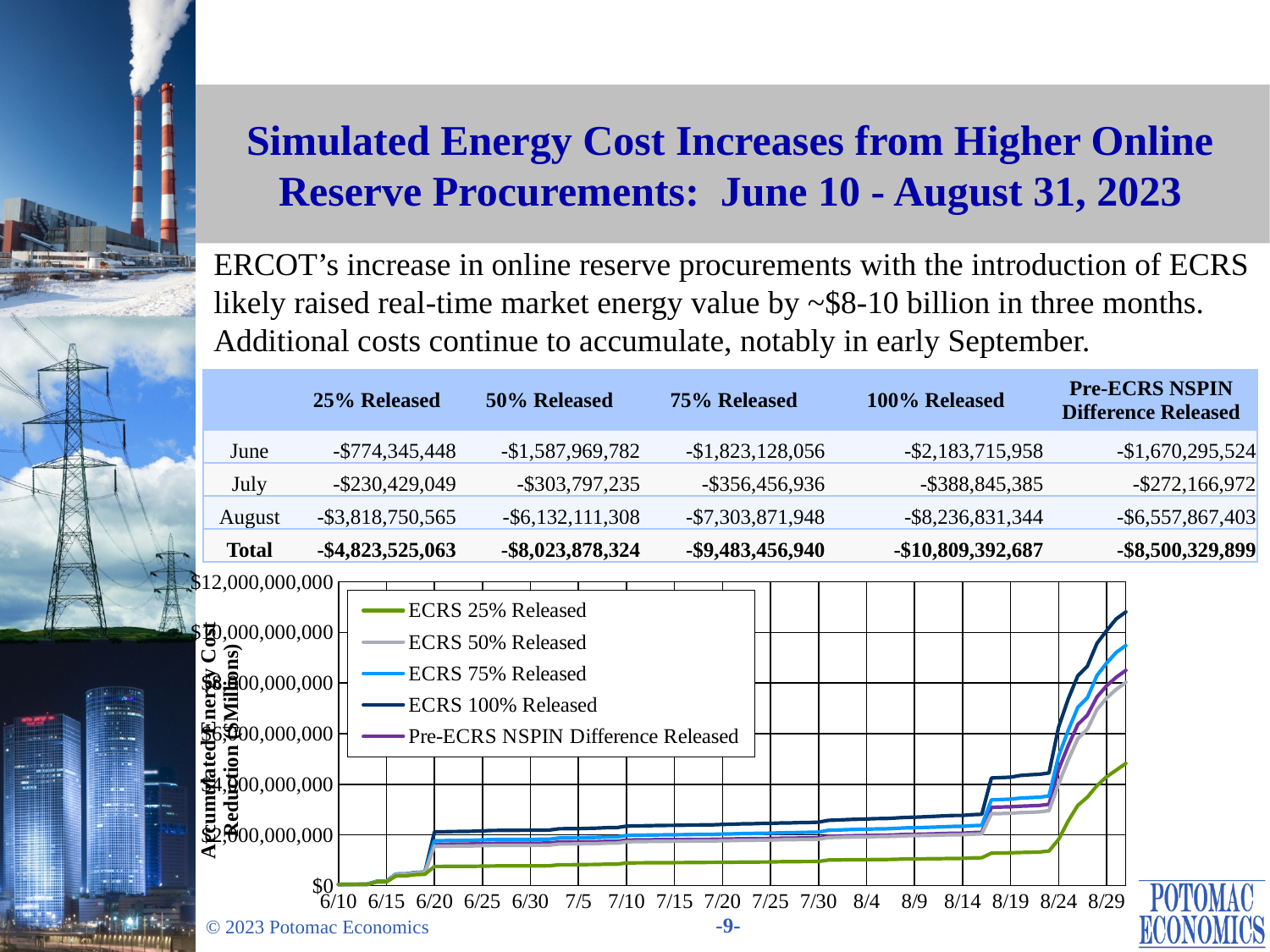
Which series in the line chart has the lowest value at the end of the period (8/29)? ECRS 25% Released In the line chart, is the value for ECRS 25% Released on 7/30 greater or less than $2,000,000,000? less Do the lines in the chart generally rise or fall from 6/10 to 8/29? rise What kind of chart is shown at the bottom of the slide? line chart How many series does the legend of the line chart list? 5 In the line chart, is the value for ECRS 75% Released at the end of the period greater or less than $8,000,000,000? greater Which series in the line chart has the highest value at the end of the period (8/29)? ECRS 100% Released What colour is the ECRS 25% Released line in the chart? green In the line chart, is the value for ECRS 25% Released at the end of the period greater or less than $6,000,000,000? less What is the first date label shown on the x axis of the line chart? 6/10 In the line chart, which is larger at the end of the period: ECRS 100% Released or ECRS 25% Released? ECRS 100% Released